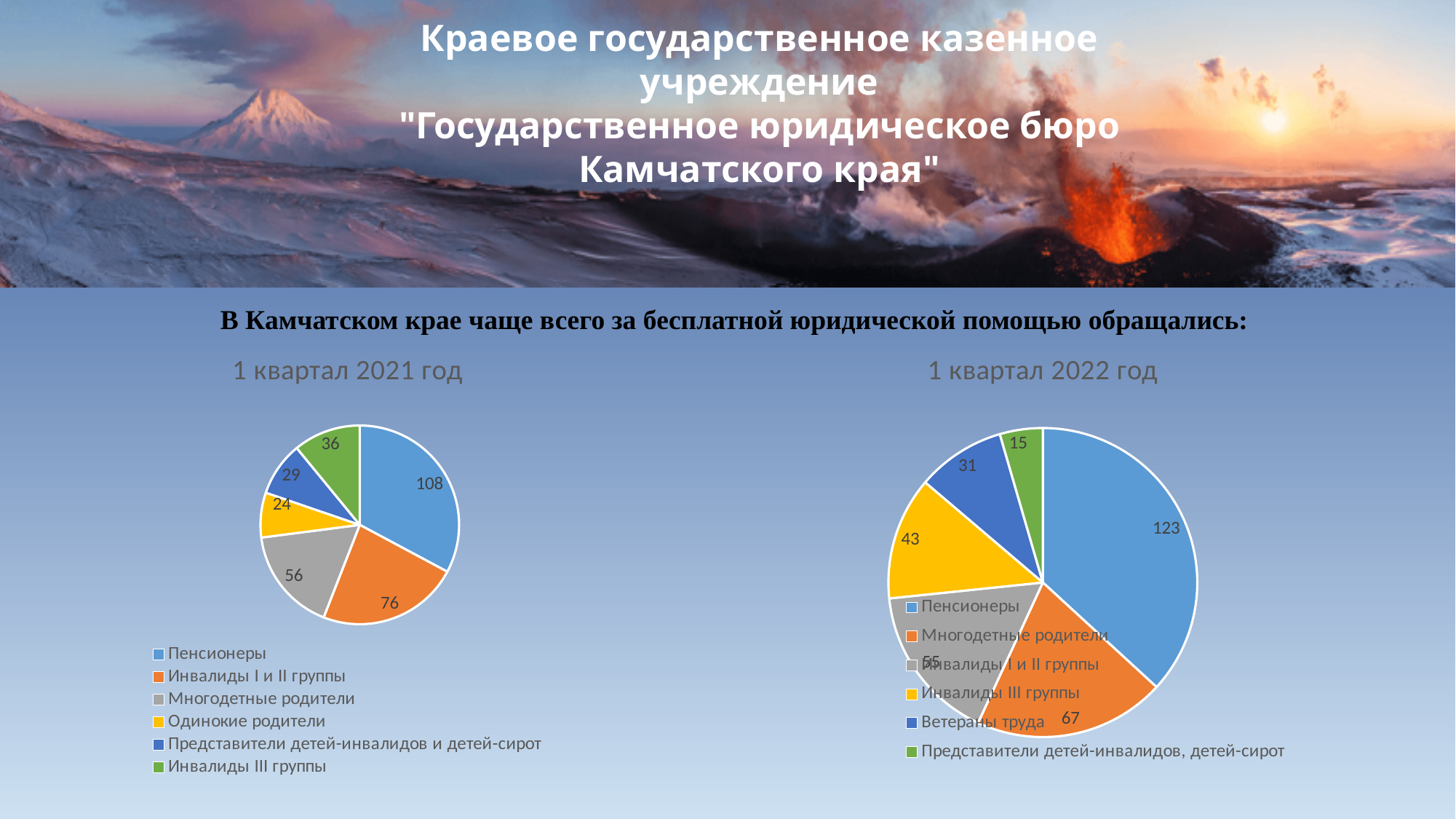
In the "1 квартал 2022 год" chart, what colour is the slice for Инвалиды III группы? yellow What is the total of all slices in the "1 квартал 2021 год" chart? 329 In the "1 квартал 2021 год" chart, what is the difference between Пенсионеры and Многодетные родители? 52 In the "1 квартал 2022 год" chart, what is the value for Ветераны труда? 31 How many categories does the "1 квартал 2021 год" chart show? 6 In the "1 квартал 2021 год" chart, which category has the smallest value? Одинокие родители In the "1 квартал 2021 год" chart, what is the value for Пенсионеры? 108 In the "1 квартал 2022 год" chart, which is larger: Многодетные родители or Инвалиды III группы? Многодетные родители In the "1 квартал 2021 год" chart, what is the value for Инвалиды I и II группы? 76 What kind of chart is shown under the title "1 квартал 2021 год"? pie chart In the "1 квартал 2022 год" chart, what is the value for Пенсионеры? 123 In the "1 квартал 2022 год" chart, which category has the largest value? Пенсионеры